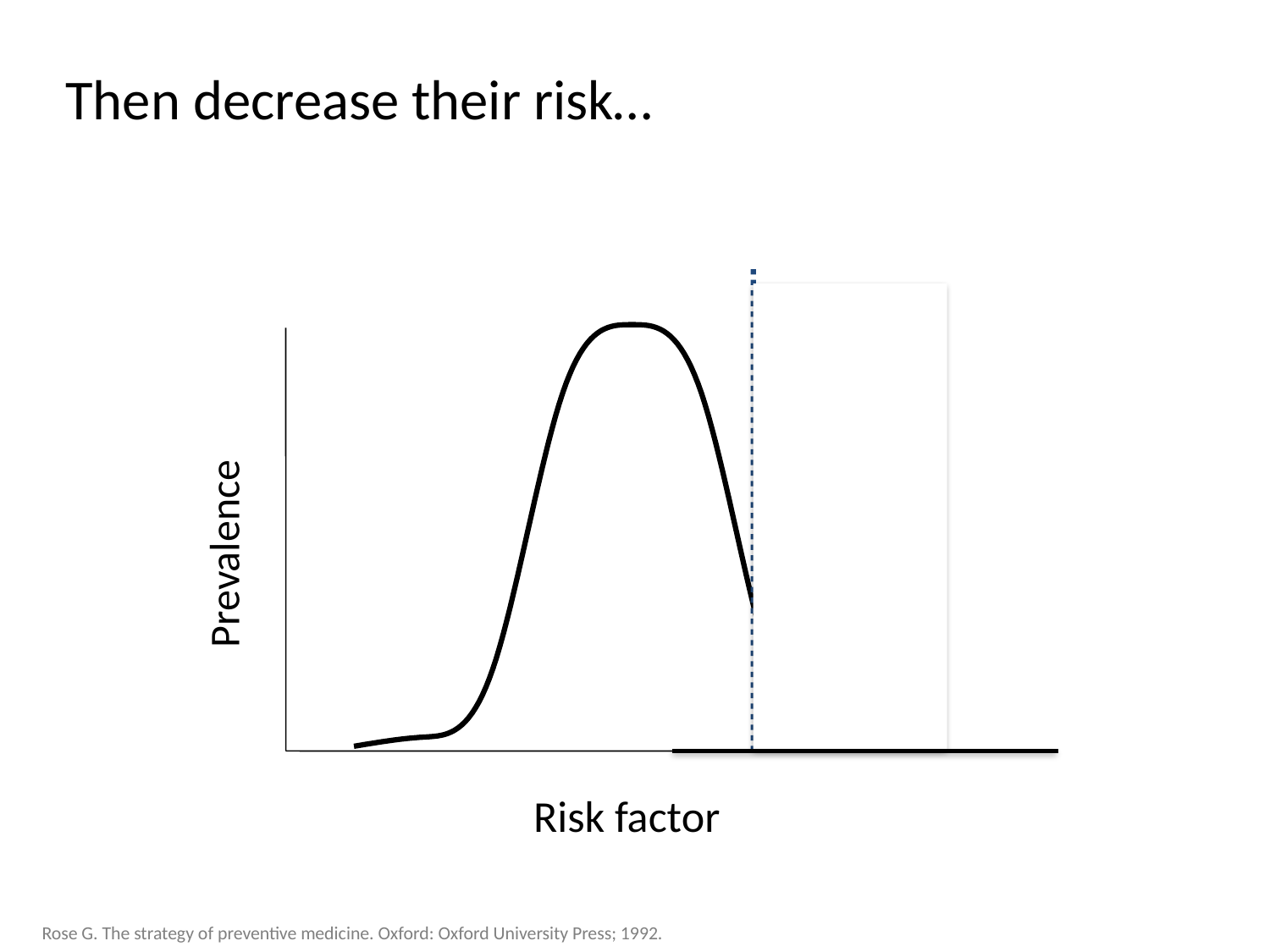
Does the curve rise or fall as the risk factor increases from the left edge toward the peak? Rises How many curves are plotted on the chart? 1 What is the label of the horizontal axis of the chart? Risk factor Does the curve rise or fall as the risk factor increases from the peak toward the dashed vertical line? Falls What kind of chart is shown on the slide? Line chart What is the label of the vertical axis of the chart? Prevalence